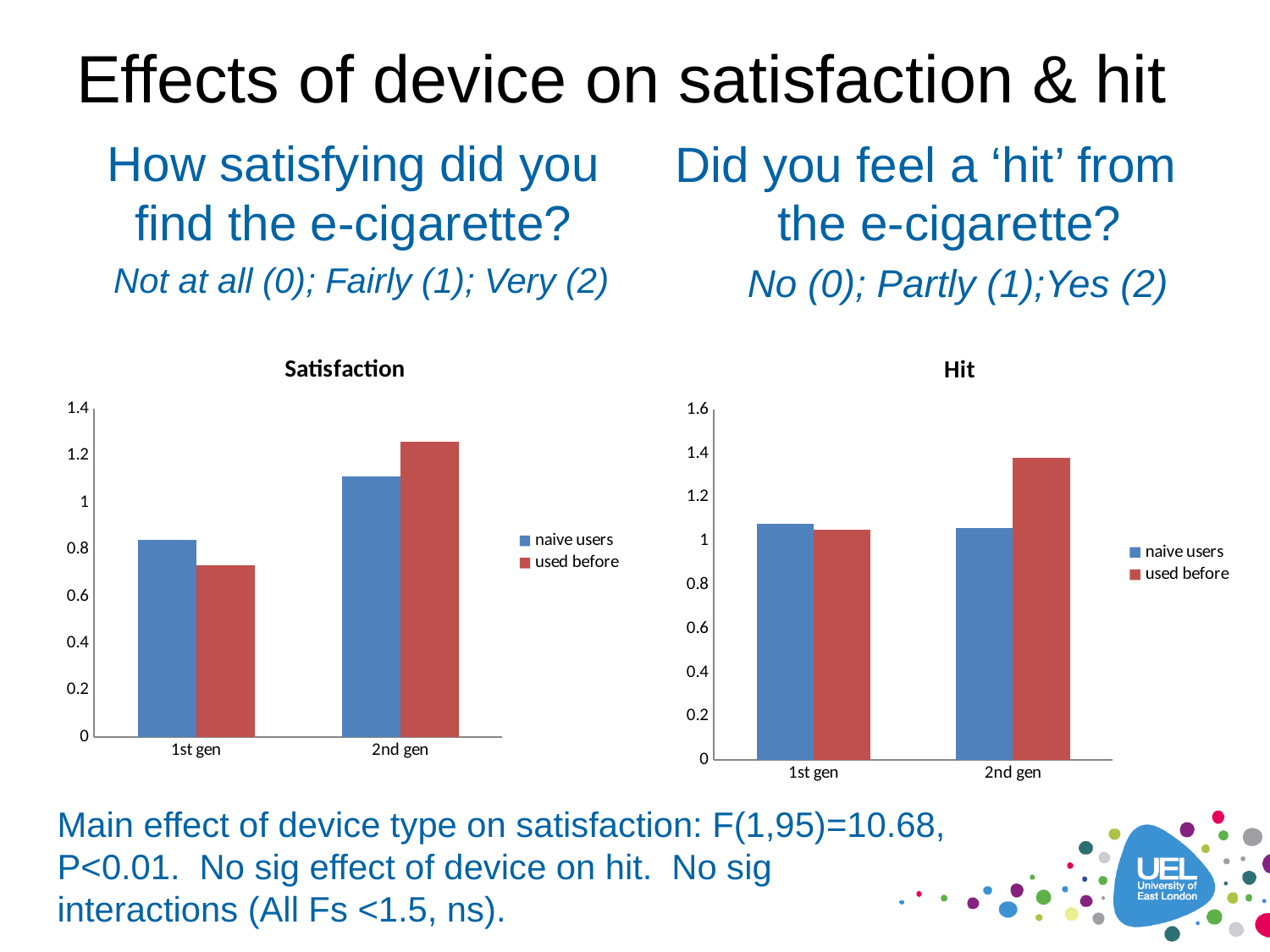
In the Hit chart, is the value for used before at 2nd gen greater or less than 1.2? greater In the Satisfaction chart, which series has the larger value at 2nd gen? used before In the Satisfaction chart, is the value for used before at 2nd gen greater or less than 1? greater How many categories are shown on the x axis of the Hit chart? 2 In the Hit chart, is the value for naive users at 1st gen greater or less than 1.2? less In the Satisfaction chart, which category has the higher value for naive users, 1st gen or 2nd gen? 2nd gen What are the two legend entries in the Hit chart? naive users, used before In the Hit chart, which bar is the highest? used before at 2nd gen What kind of chart is the Satisfaction chart? bar chart How many series does the legend of the Satisfaction chart list? 2 In the Satisfaction chart, which series has the larger value at 1st gen? naive users